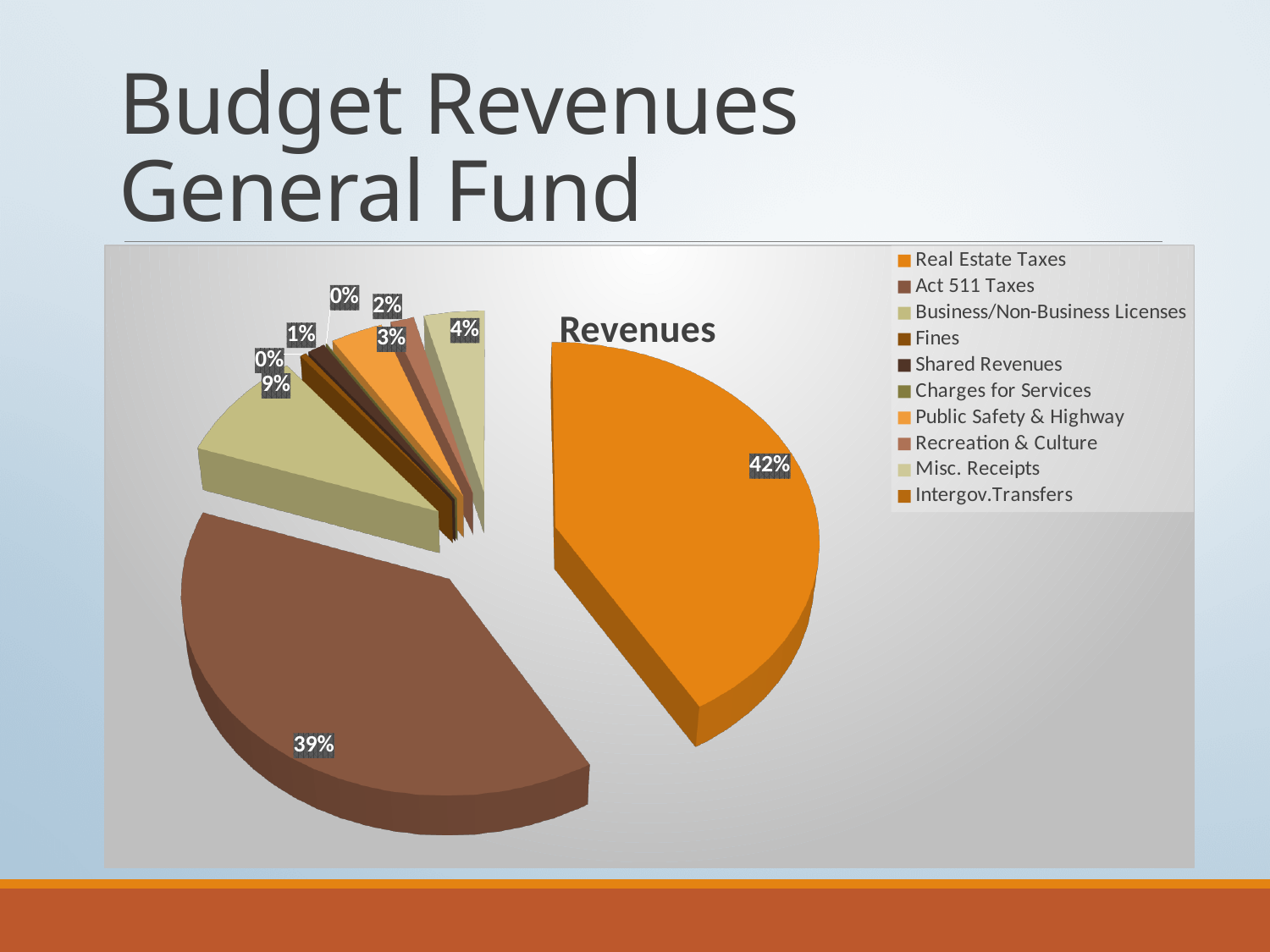
What percentage is shown for Business/Non-Business Licenses? 9% What is the title of the chart? Revenues Which is larger, the share for Business/Non-Business Licenses or the share for Misc. Receipts? Business/Non-Business Licenses How many categories does the chart's legend list? 10 Which category has the largest share of revenues? Real Estate Taxes Which is larger, the share for Real Estate Taxes or the share for Act 511 Taxes? Real Estate Taxes What percentage is shown for Misc. Receipts? 4% By how many percentage points does the Real Estate Taxes share exceed the Act 511 Taxes share? 3 percentage points What share of revenues comes from Act 511 Taxes? 39% What colour is the Real Estate Taxes slice? Orange What kind of chart is shown on the slide? Pie chart What share of revenues comes from Real Estate Taxes? 42%